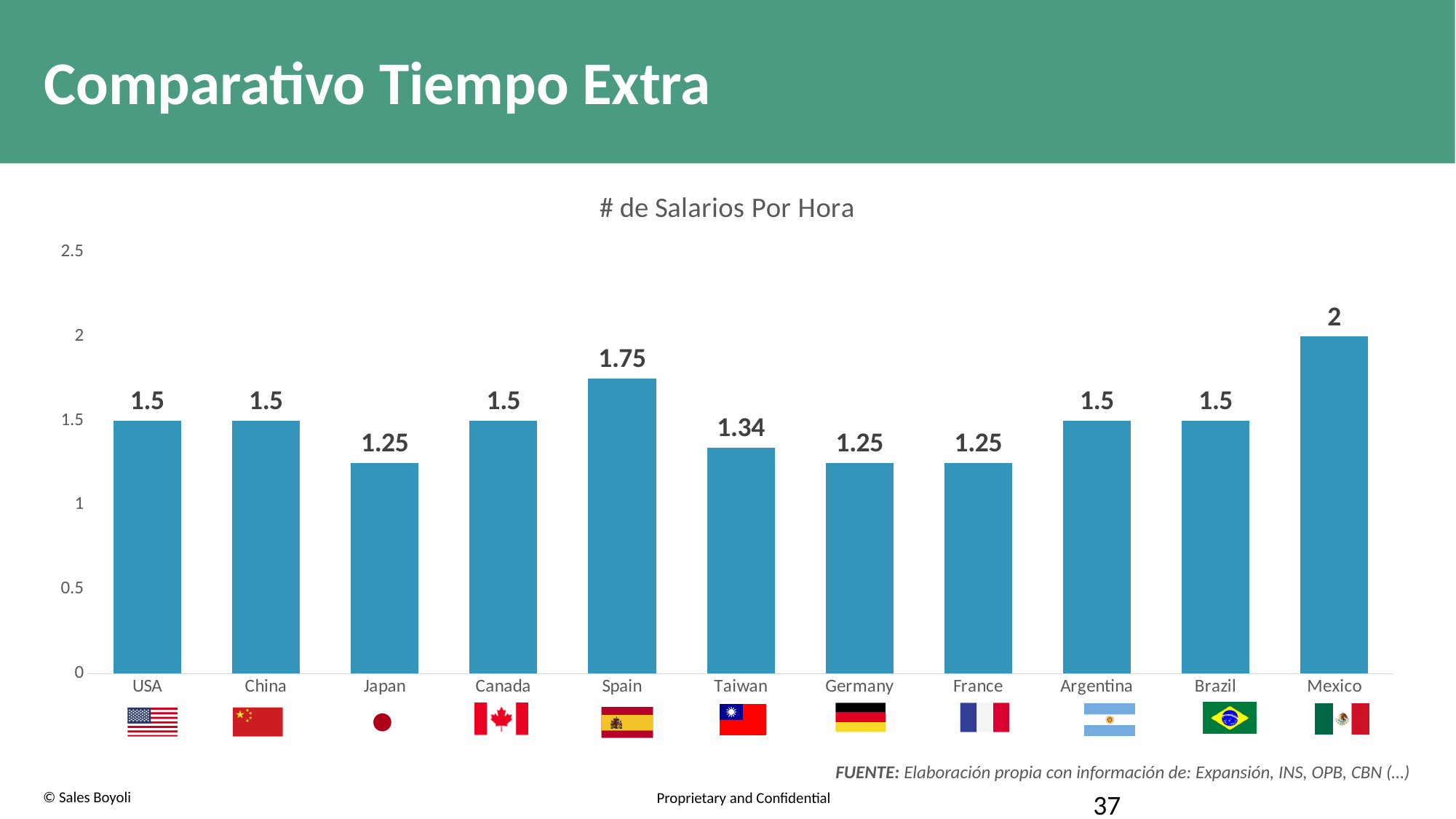
What is the difference between the values for Mexico and Spain? 0.25 Is the value for Mexico greater or less than 1.5? greater Which is larger, the value for Spain or the value for Canada? Spain What kind of chart is shown on the slide? Bar chart What is the difference between the values for Taiwan and Japan? 0.09 What is the value for Germany? 1.25 Which country has the highest value? Mexico How many countries are shown on the chart? 11 What is the title of the chart? # de Salarios Por Hora What is the value for Spain? 1.75 Which is larger, the value for Taiwan or the value for France? Taiwan What is the value for Taiwan? 1.34